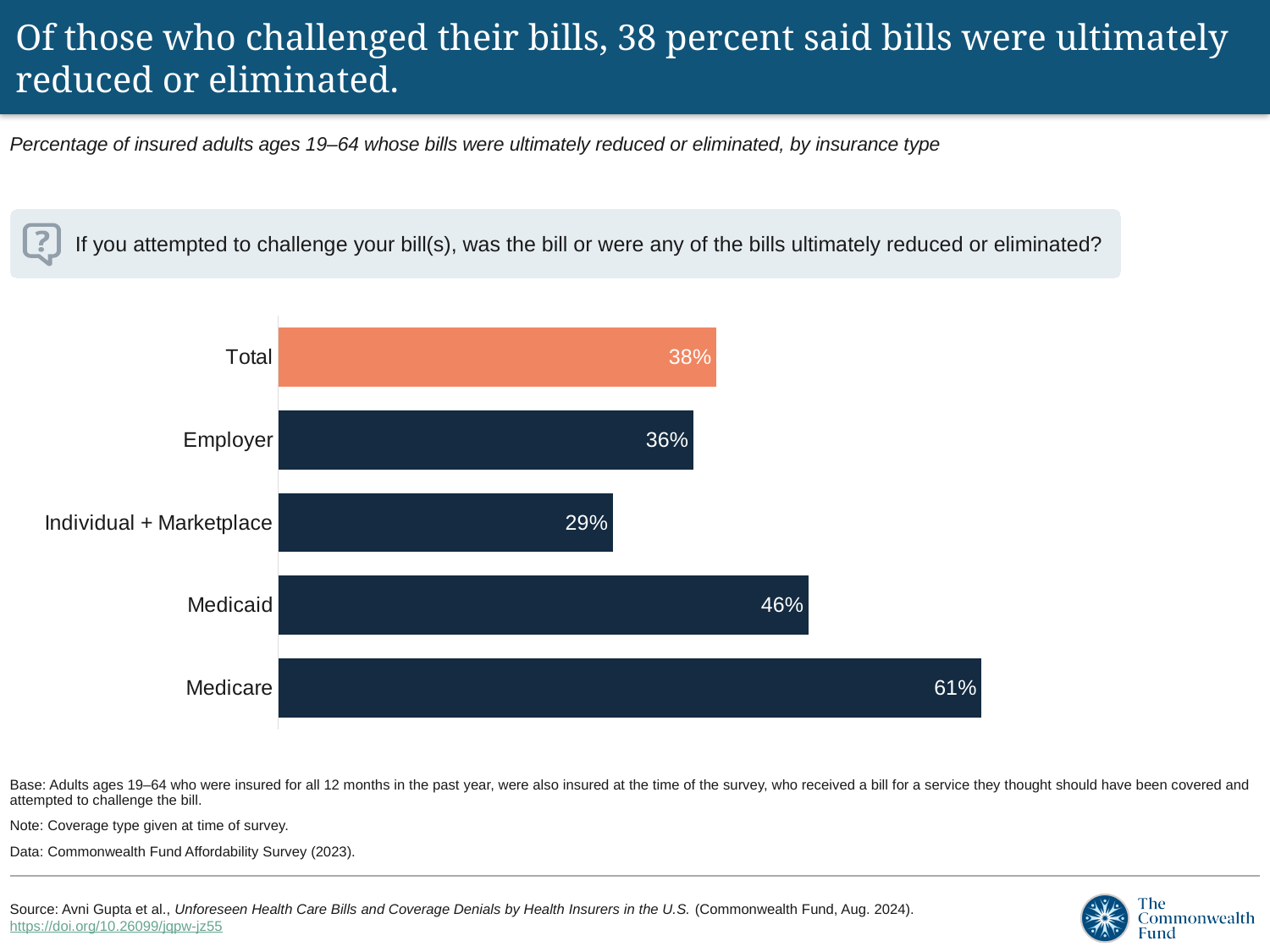
What percentage is shown for Individual + Marketplace? 29% Which insurance type has the lowest percentage of bills reduced or eliminated? Individual + Marketplace What is the difference in percentage points between Medicare and Employer? 25 percentage points What type of chart is shown on the slide? Bar chart How many bars are shown in the chart? 5 Which bar is shown in a different colour (orange) from the others? Total What is the difference between the Medicaid value and the Total value? 8 percentage points What percentage of Medicare enrollees said their bills were ultimately reduced or eliminated? 61% Which insurance type has the highest percentage of bills reduced or eliminated? Medicare Which is larger, the value for Employer or the value for Medicaid? Medicaid What is the value for Medicaid? 46% What is the value shown for the Total bar? 38%